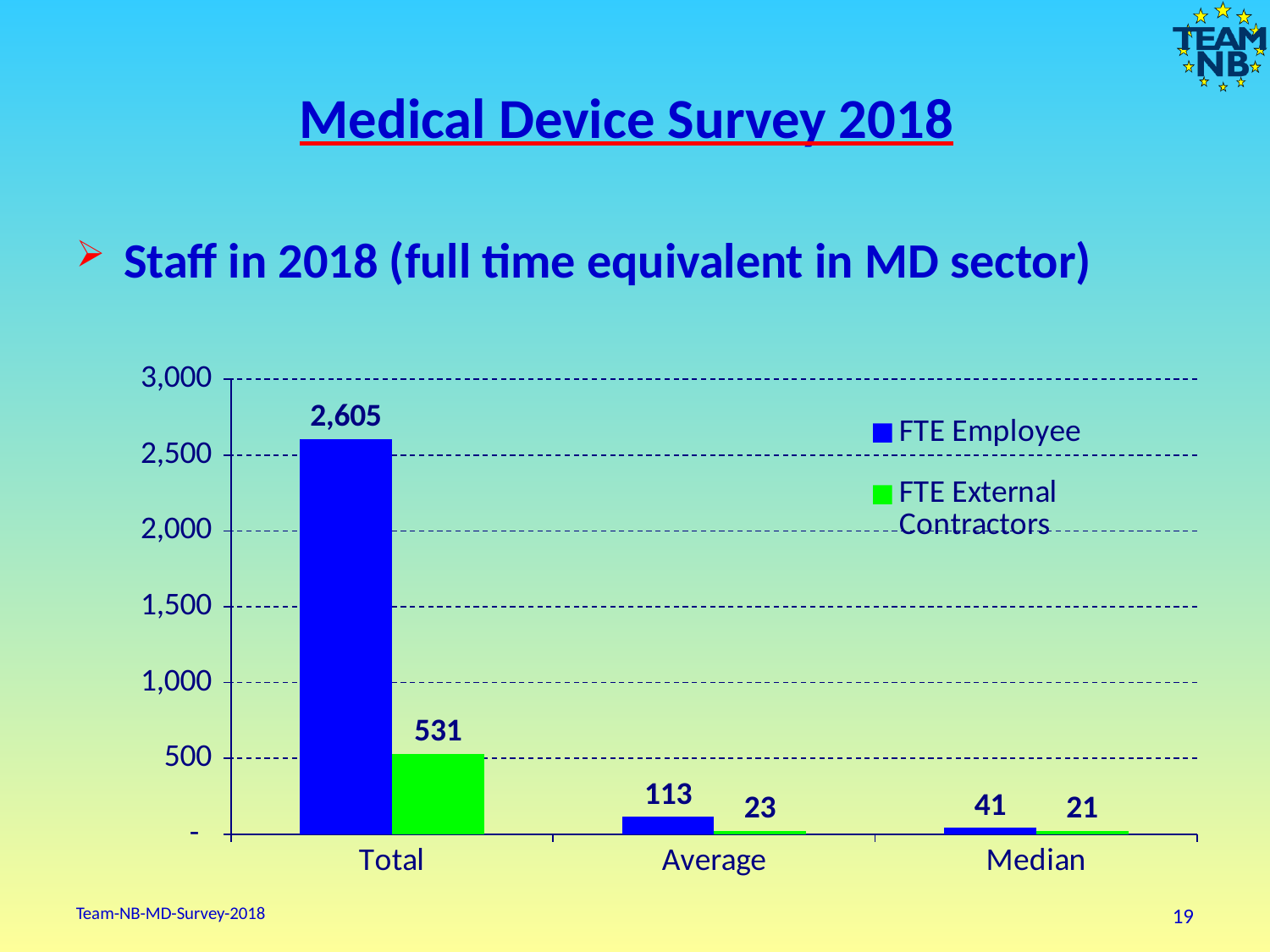
What is the difference between the FTE Employee values for Average and Median? 72 What is the FTE External Contractors value for Median? 21 Which category has the lowest FTE External Contractors value? Median What is the FTE External Contractors value for Total? 531 Which category has the highest FTE Employee value? Total What is the difference between the FTE Employee and FTE External Contractors values for Total? 2,074 What is the FTE Employee value for Total? 2,605 How many series does the legend list? 2 Which is larger for Average: FTE Employee or FTE External Contractors? FTE Employee What is the FTE Employee value for Average? 113 How many categories are shown on the x axis? 3 What kind of chart is shown on the slide? Bar chart